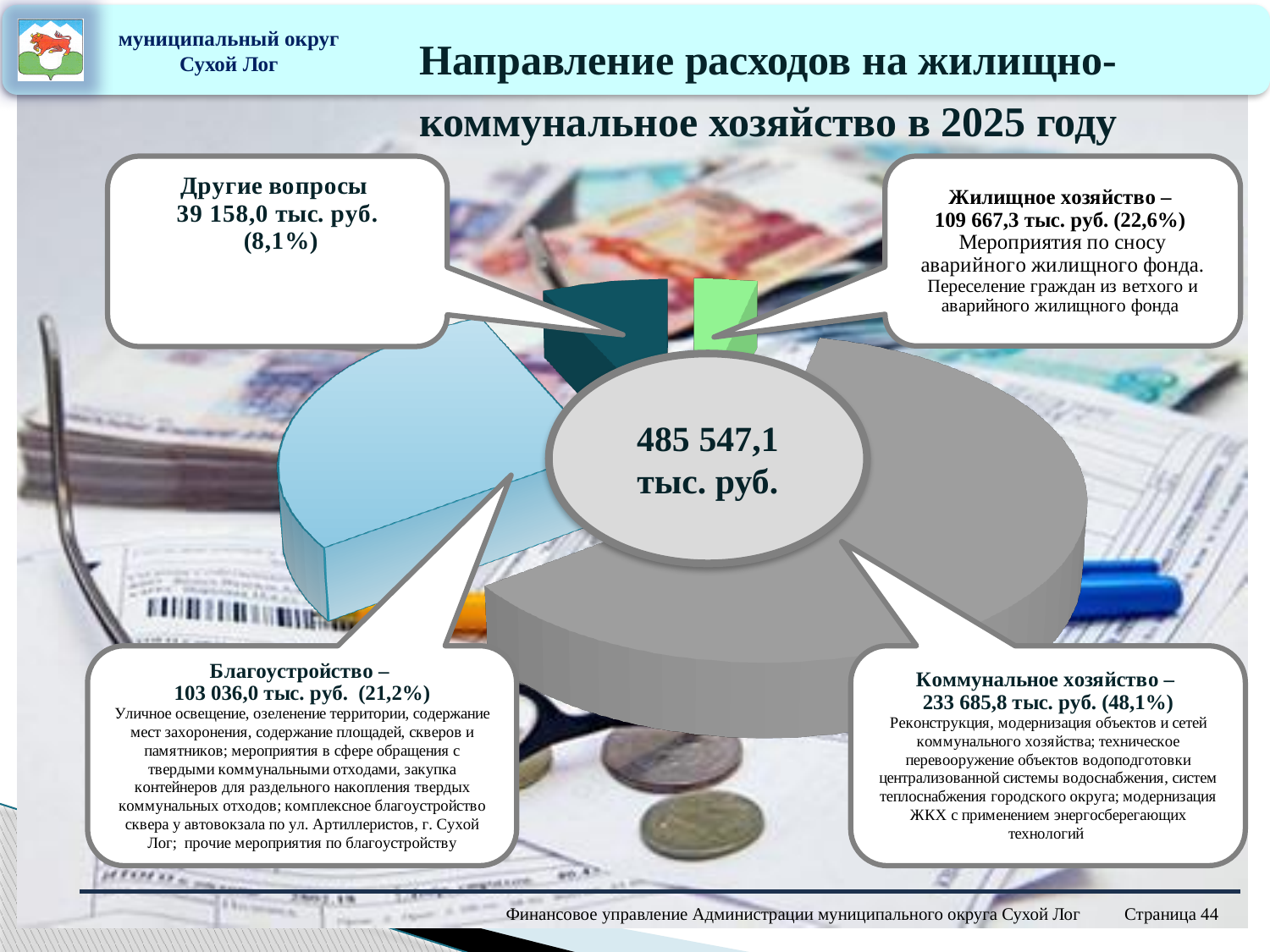
How many categories (slices) does the pie chart have? 4 What is the total amount shown in the centre of the pie chart? 485 547,1 тыс. руб. What is the title of the slide containing the pie chart? Направление расходов на жилищно-коммунальное хозяйство в 2025 году What is the value for Коммунальное хозяйство? 233 685,8 тыс. руб. What share of the pie does Коммунальное хозяйство represent? 48,1% What is the value for Жилищное хозяйство? 109 667,3 тыс. руб. What is the value for Другие вопросы? 39 158,0 тыс. руб. What kind of chart is shown on the slide? pie chart Which category has the largest share of the pie chart? Коммунальное хозяйство What is the value for Благоустройство? 103 036,0 тыс. руб.